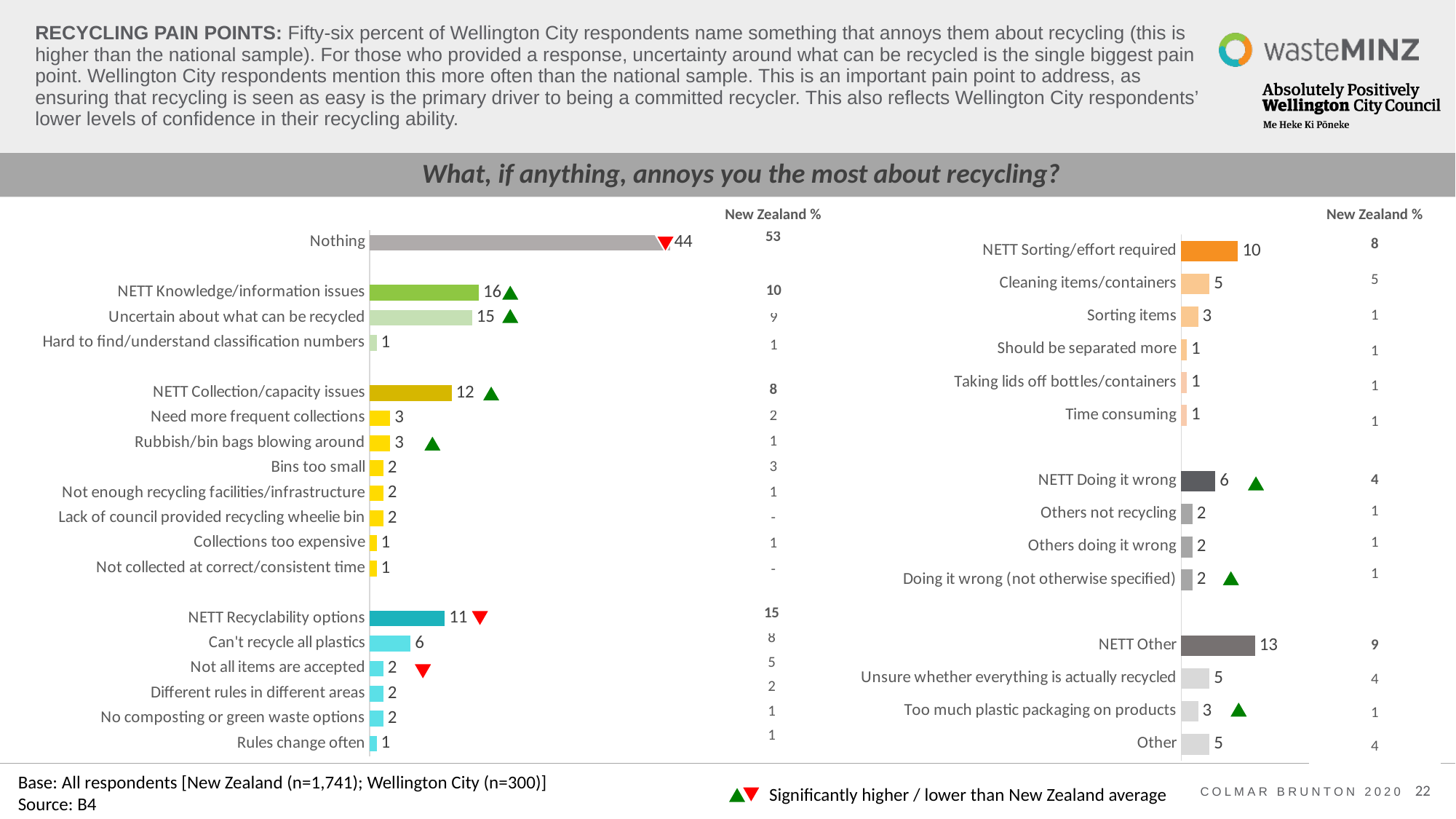
On the left chart, which category has the highest value? Nothing On the right chart, which category has the highest value? NETT Other What type of chart is used on the slide? Bar chart On the left chart, what is the difference between "NETT Knowledge/information issues" and "NETT Collection/capacity issues"? 4 On the left chart, which is larger: "Can't recycle all plastics" or "Need more frequent collections"? Can't recycle all plastics On the left chart, what is the New Zealand % shown for "Nothing"? 53 On the left chart, what is the Wellington City value for "Nothing"? 44 How many categories are plotted on the right chart? 14 On the left chart, what is the value for "Uncertain about what can be recycled"? 15 On the right chart, what is the difference between "NETT Sorting/effort required" and "NETT Doing it wrong"? 4 On the right chart, what is the value for "NETT Other"? 13 On the right chart, what is the value for "Cleaning items/containers"? 5